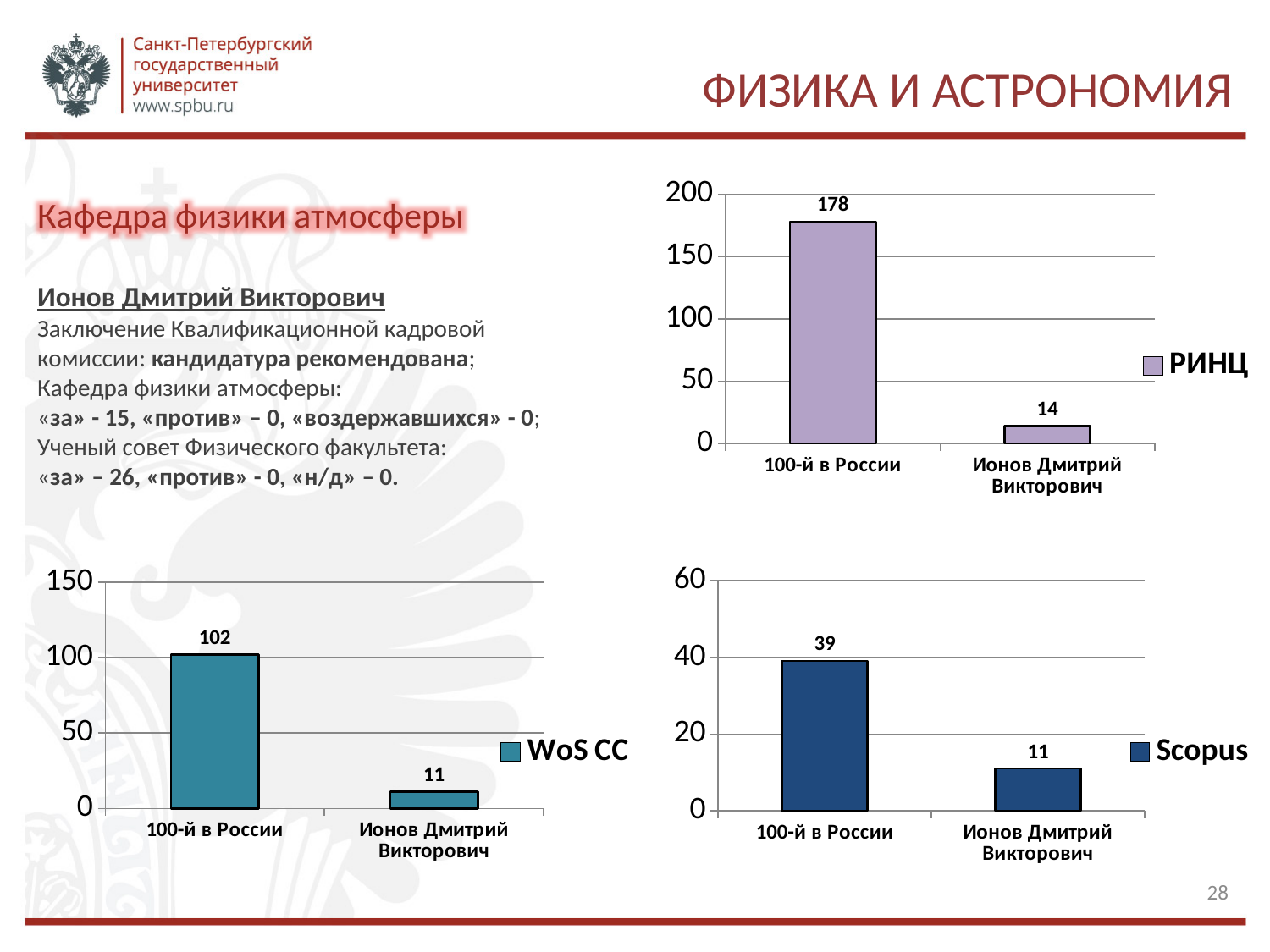
In the РИНЦ chart (top right), what is the difference between the values for 100-й в России and Ионов Дмитрий Викторович? 164 In the Scopus chart (bottom right), what is the value for 100-й в России? 39 In the WoS CC chart (bottom left), what is the value for 100-й в России? 102 What kind of chart is the WoS CC chart (bottom left)? bar chart How many categories are shown in the Scopus chart (bottom right)? 2 In the Scopus chart (bottom right), what is the value for Ионов Дмитрий Викторович? 11 In the WoS CC chart (bottom left), what is the value for Ионов Дмитрий Викторович? 11 In the РИНЦ chart (top right), what is the value for Ионов Дмитрий Викторович? 14 In the РИНЦ chart (top right), what is the value for 100-й в России? 178 In the WoS CC chart (bottom left), what is the difference between the values for 100-й в России and Ионов Дмитрий Викторович? 91 In the РИНЦ chart (top right), which category has the lowest value? Ионов Дмитрий Викторович In the Scopus chart (bottom right), which category has the highest value? 100-й в России